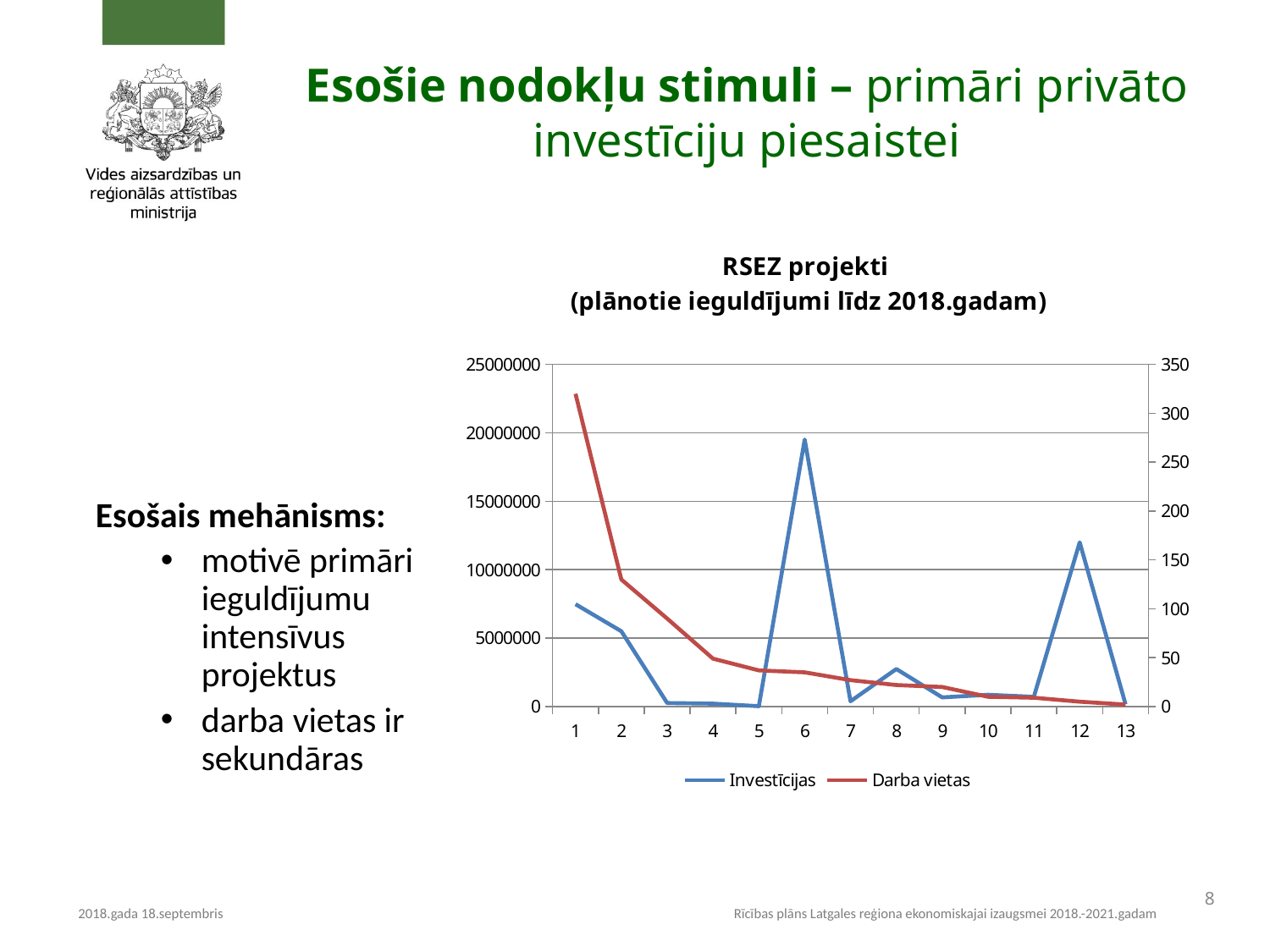
Is the value for Investīcijas at category 6 greater or less than 15000000? greater Which category has the highest value for Investīcijas? 6 What is the title of the chart? RSEZ projekti (plānotie ieguldījumi līdz 2018.gadam) Which category has the highest value for Darba vietas? 1 Which is larger, the Investīcijas value at category 6 or at category 12? category 6 How many series does the chart legend list? 2 How many categories are plotted along the x axis of the chart? 13 Is the value for Investīcijas at category 12 greater or less than 10000000? greater What kind of chart is shown on the slide? line chart Which category has the lowest value for Darba vietas? 13 Is the value for Darba vietas at category 1 greater or less than 300? greater Does the Darba vietas series generally rise or fall from category 1 to category 13? fall